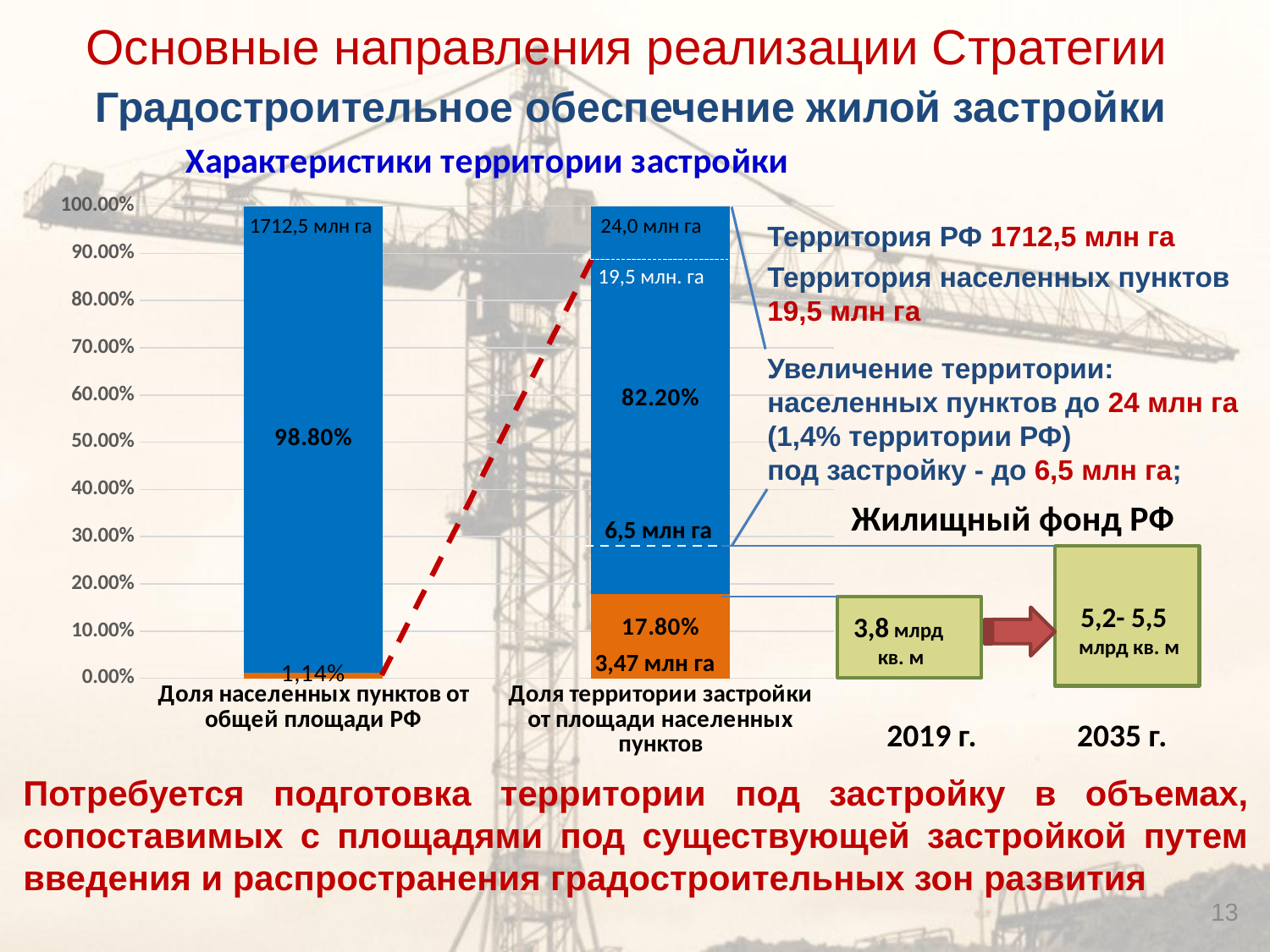
In the chart 'Характеристики территории застройки', what area in млн га is labelled on the orange segment of 'Доля территории застройки от площади населенных пунктов'? 3,47 млн га In the chart 'Характеристики территории застройки', what is the blue segment value for 'Доля территории застройки от площади населенных пунктов'? 82.20% What type of chart is shown under the heading 'Характеристики территории застройки'? stacked bar chart What is the maximum value shown on the y axis of the chart 'Характеристики территории застройки'? 100.00% How many categories are shown on the x axis of the chart 'Характеристики территории застройки'? 2 In the chart 'Характеристики территории застройки', what is the difference between the blue segment values of the two bars (98.80% and 82.20%)? 16.60% In the chart 'Характеристики территории застройки', what is the orange segment value for 'Доля населенных пунктов от общей площади РФ'? 1,14% In the chart 'Характеристики территории застройки', what is the orange segment value for 'Доля территории застройки от площади населенных пунктов'? 17.80% In the chart 'Характеристики территории застройки', which category has the larger orange segment? Доля территории застройки от площади населенных пунктов In the chart 'Характеристики территории застройки', what area in млн га is labelled at the top of the bar 'Доля населенных пунктов от общей площади РФ'? 1712,5 млн га In the chart 'Характеристики территории застройки', what is the blue segment value for 'Доля населенных пунктов от общей площади РФ'? 98.80% In the chart 'Характеристики территории застройки', is the orange segment for 'Доля территории застройки от площади населенных пунктов' greater or less than 20.00%? less